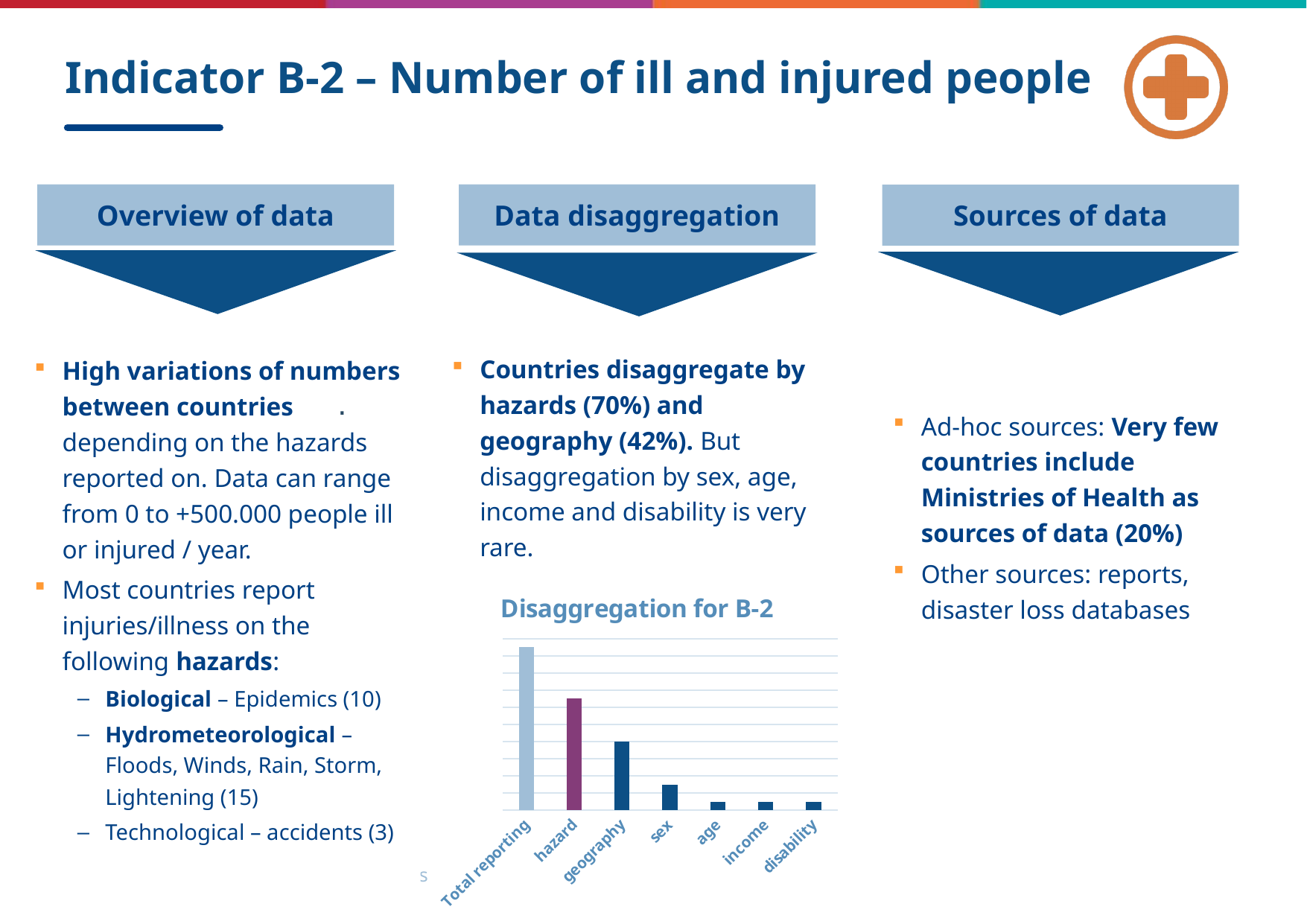
Do the bar heights generally rise or fall moving from left to right along the x axis? fall Which category has the tallest bar in the chart? Total reporting Which bar is taller, Total reporting or hazard? Total reporting What is the title of the chart? Disaggregation for B-2 How many categories are shown on the x axis of the chart? 7 Which bar is taller, sex or geography? geography Which bar is taller, hazard or geography? hazard What type of chart is shown on the slide? bar chart Which category has the second tallest bar in the chart? hazard Which category's bar is coloured purple in the chart? hazard